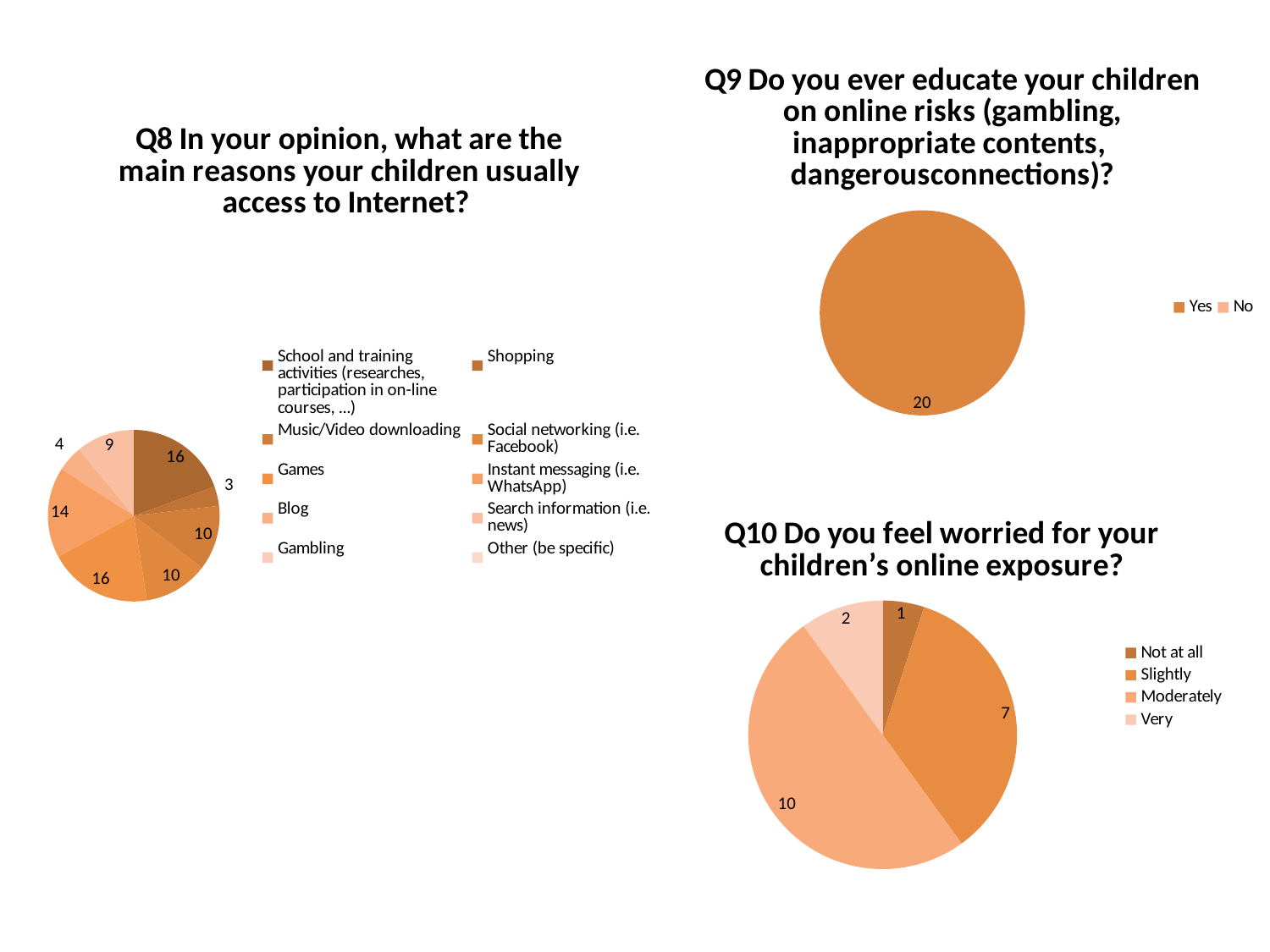
On the Q10 chart, what is the total of all the slices? 20 On the Q9 chart, how many entries does the legend list? 2 What kind of chart is the Q8 chart (main reasons your children usually access to Internet)? pie chart On the Q10 chart, which category has the smallest slice? Not at all On the Q10 chart, which category has the largest slice? Moderately On the Q10 chart, which is larger, Slightly or Very? Slightly On the Q9 chart (Do you ever educate your children on online risks?), what is the value for Yes? 20 On the Q10 chart, what is the difference between the values for Moderately and Slightly? 3 On the Q10 chart, what share of the pie does Moderately represent? 50% On the Q8 chart, how many categories does the legend list? 10 On the Q10 chart, what is the value for Slightly? 7 On the Q10 chart (Do you feel worried for your children's online exposure?), what is the value for Moderately? 10